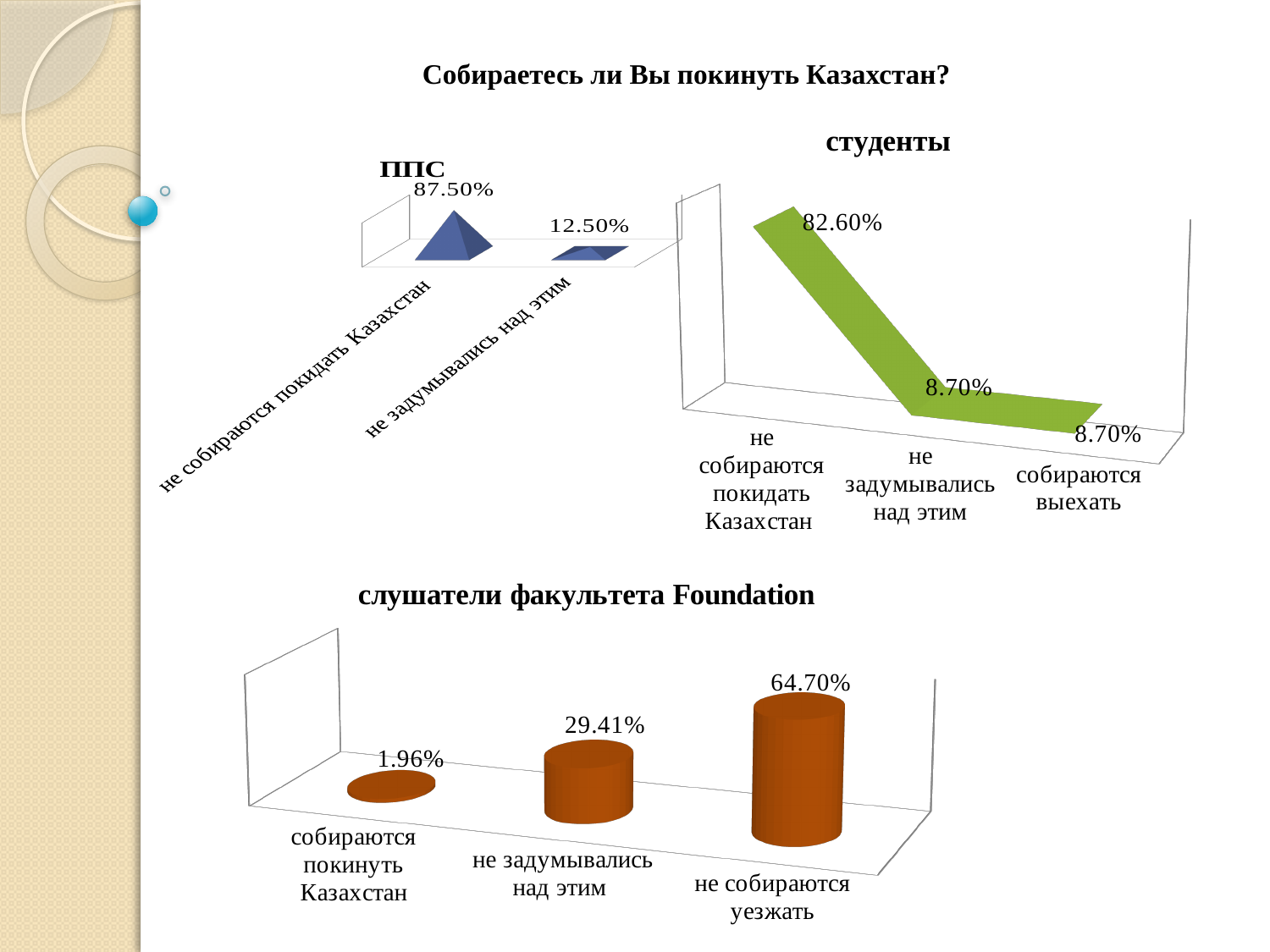
What kind of chart is the слушатели факультета Foundation chart? bar chart In the студенты chart, what is the value for "не собираются покидать Казахстан"? 82.60% In the ППС chart, what is the value for "не задумывались над этим"? 12.50% In the слушатели факультета Foundation chart, what is the value for "не задумывались над этим"? 29.41% In the студенты chart, which category has the highest value? не собираются покидать Казахстан In the ППС chart, what is the value for "не собираются покидать Казахстан"? 87.50% In the студенты chart, how many categories are shown on the x axis? 3 In the слушатели факультета Foundation chart, what is the difference between "не собираются уезжать" and "не задумывались над этим"? 35.29% In the ППС chart, how many categories are shown? 2 In the ППС chart, what is the difference between the two values? 75.00% In the студенты chart, what is the value for "собираются выехать"? 8.70% In the слушатели факультета Foundation chart, which category has the lowest value? собираются покинуть Казахстан